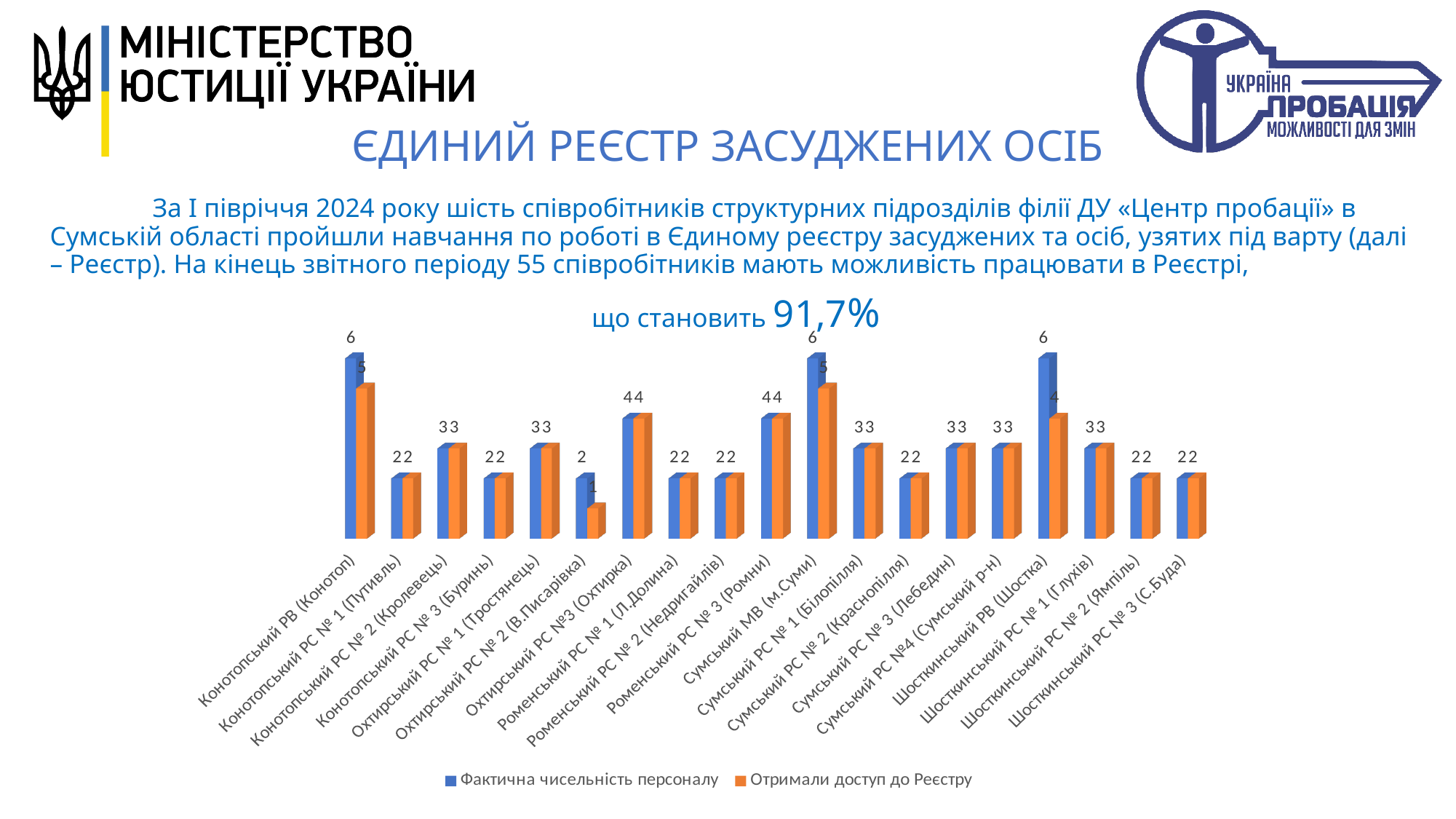
What is the value of "Отримали доступ до Реєстру" for Шосткинський РВ (Шостка)? 4 Which series is shown in orange in the chart legend? Отримали доступ до Реєстру Which category has the lowest value for "Отримали доступ до Реєстру"? Охтирський РС № 2 (В.Писарівка) What is the difference between "Фактична чисельність персоналу" and "Отримали доступ до Реєстру" for Сумський МВ (м.Суми)? 1 What is the value of "Фактична чисельність персоналу" for Конотопський РВ (Конотоп)? 6 How many categories are shown on the x axis of the chart? 19 What is the value of "Фактична чисельність персоналу" for Роменський РС № 3 (Ромни)? 4 What is the difference between "Фактична чисельність персоналу" and "Отримали доступ до Реєстру" for Шосткинський РВ (Шостка)? 2 How many series does the chart legend list? 2 Which is larger: "Фактична чисельність персоналу" for Охтирський РС №3 (Охтирка) or for Сумський РС № 1 (Білопілля)? Охтирський РС №3 (Охтирка) What is the value of "Отримали доступ до Реєстру" for Охтирський РС № 2 (В.Писарівка)? 1 What kind of chart is shown on the slide? Bar chart